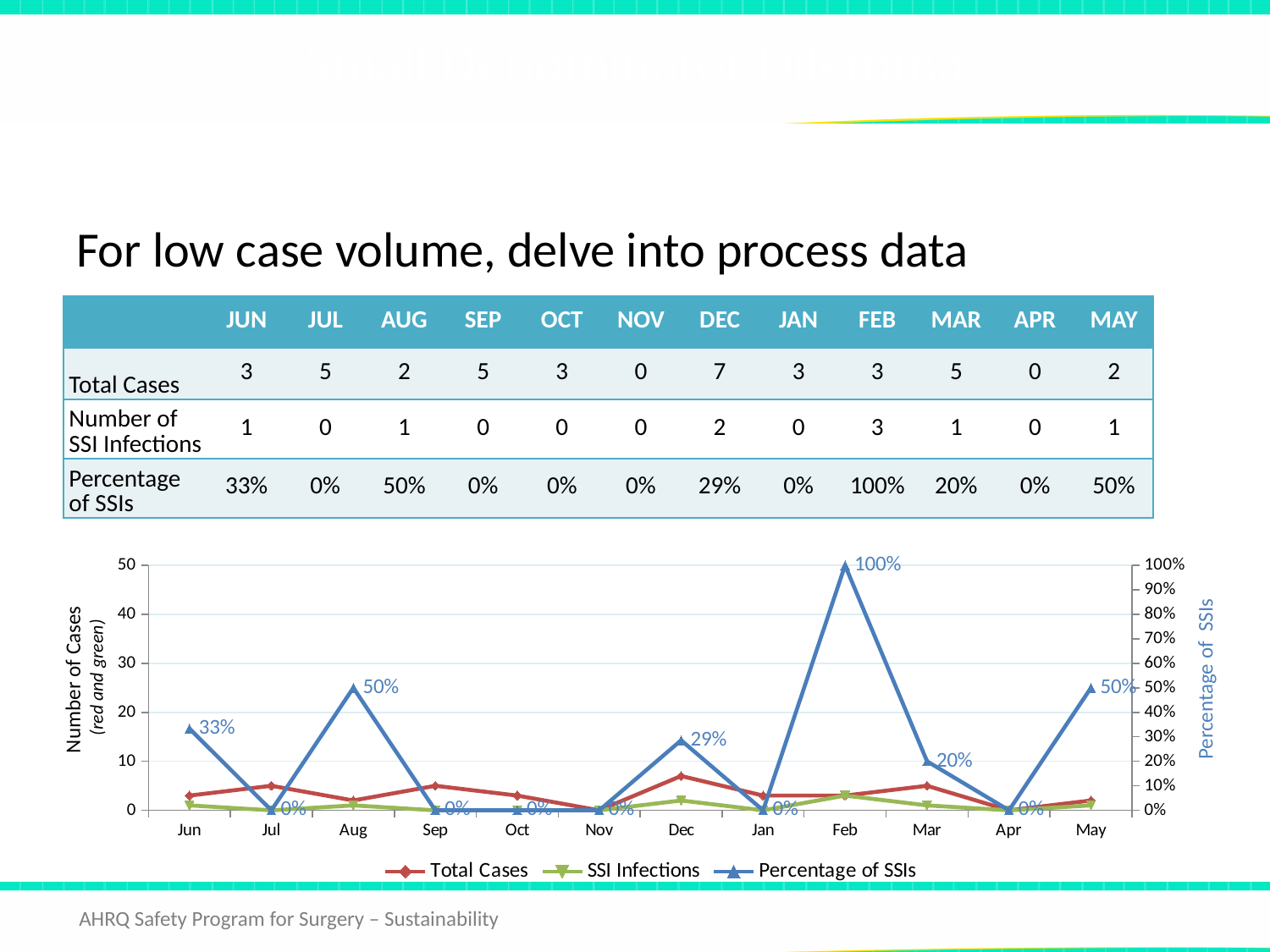
What type of chart is shown on the slide? Line chart Is the Percentage of SSIs for Aug greater or less than the Percentage of SSIs for Dec? greater Which month has the highest Percentage of SSIs in the chart? Feb What is the Percentage of SSIs for Jun in the chart? 33% How many months are plotted along the x axis of the chart? 12 What is the difference between the Percentage of SSIs in Feb and in Mar? 80% Is the Percentage of SSIs for Mar greater or less than 30%? less What is the Percentage of SSIs for Feb in the chart? 100% How many series does the chart legend list? 3 What is the Total Cases value for Dec? 7 What is the Percentage of SSIs for Dec in the chart? 29% Which series in the chart is plotted in blue? Percentage of SSIs